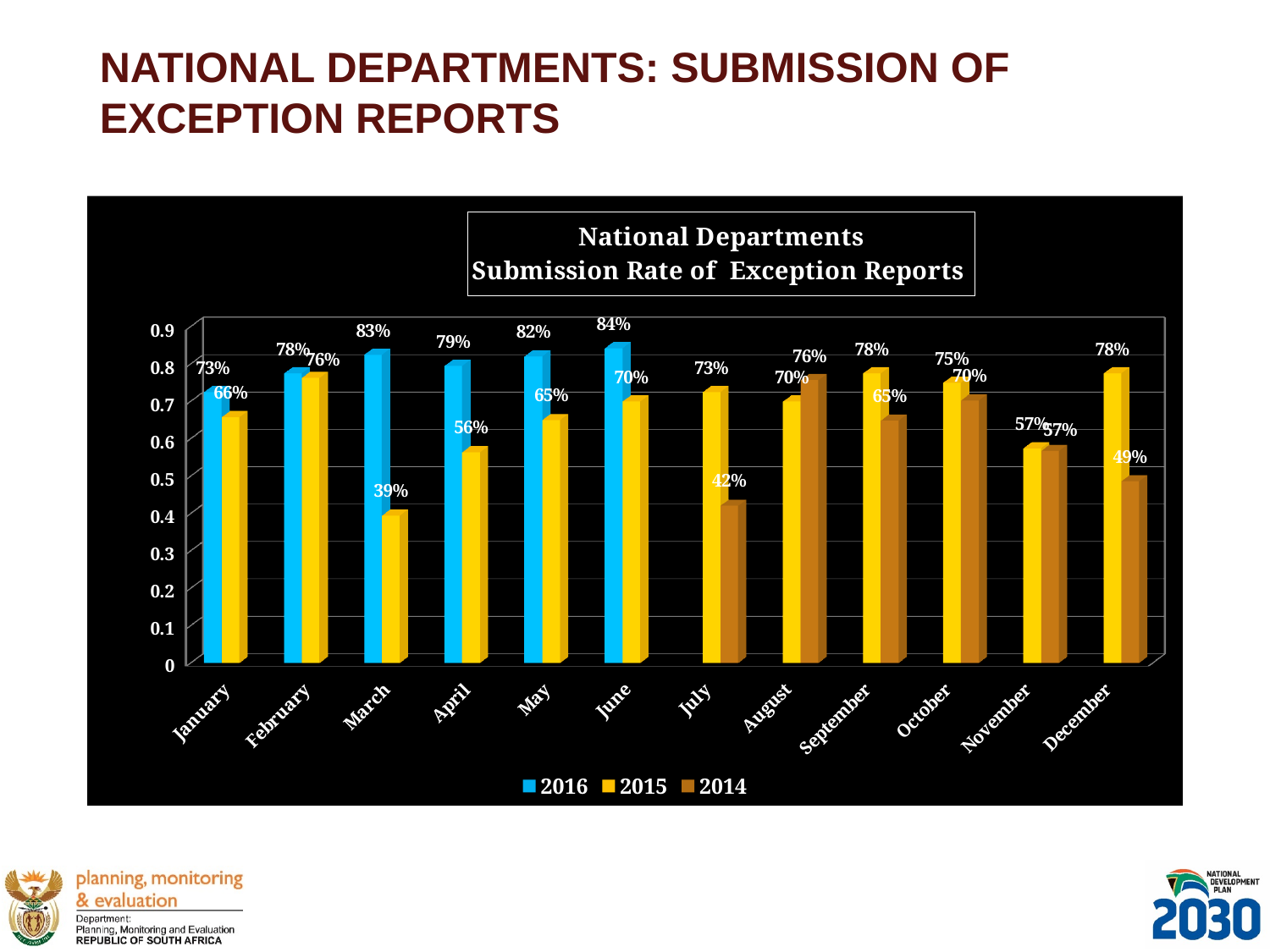
What is the 2015 submission rate for November? 57% In August, which year has the higher submission rate, 2015 or 2014? 2014 Which month has the lowest 2014 submission rate? July What is the 2015 submission rate for March? 39% What kind of chart is shown on the slide? Bar chart How many months are shown on the x axis? 12 What is the difference between the 2016 and 2015 submission rates in March? 44 percentage points What is the 2016 submission rate for June? 84% What is the 2014 submission rate for December? 49% How many series does the legend list? 3 Which month has the lowest 2015 submission rate? March Which month has the highest 2016 submission rate? June